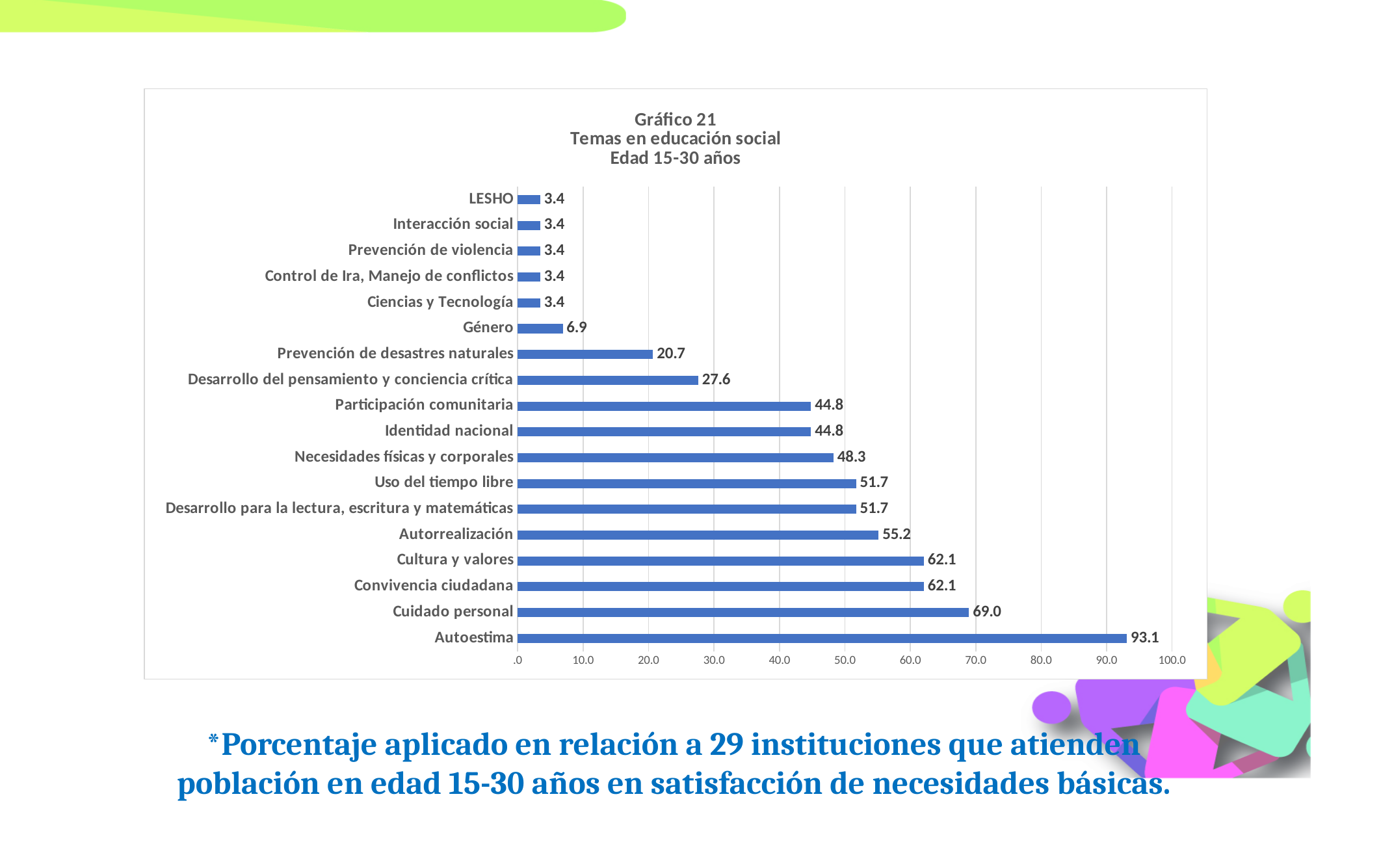
What kind of chart is shown on the slide? bar chart What is the value for Autoestima? 93.1 How many categories are shown in the chart? 18 What is the difference between the values for Autorrealización and Necesidades físicas y corporales? 6.9 What is the value for Prevención de desastres naturales? 20.7 What is the value for Cuidado personal? 69.0 What is the title of the chart? Gráfico 21 Temas en educación social Edad 15-30 años What is the difference between the values for Autoestima and Cuidado personal? 24.1 Which is larger, the value for Cultura y valores or the value for Autorrealización? Cultura y valores Which category has the highest value? Autoestima What is the value for Género? 6.9 Is the value for Desarrollo del pensamiento y conciencia crítica greater or less than 30.0? less